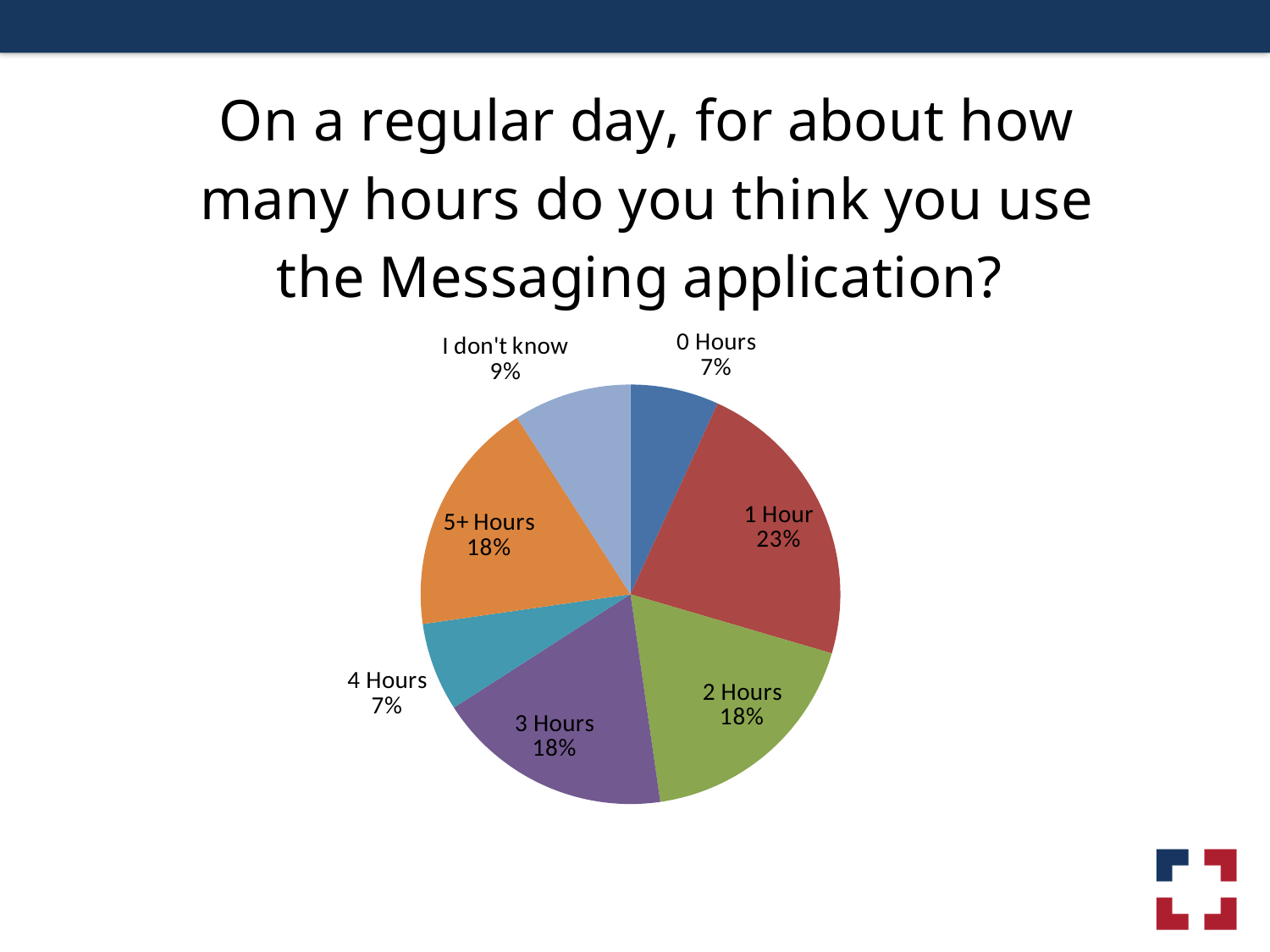
What percentage is shown for "5+ Hours"? 18% What colour is the "1 Hour" slice? Red How many categories share the value 18%? 3 What percentage is shown for "I don't know"? 9% What is the difference in percentage points between "1 Hour" and "0 Hours"? 16 Which category has the largest slice of the pie? 1 Hour What percentage is shown for "4 Hours"? 7% What share of the pie does the "1 Hour" slice represent? 23% Which is larger, the share for "3 Hours" or the share for "4 Hours"? 3 Hours What is the difference in percentage points between "2 Hours" and "I don't know"? 9 How many categories (slices) does the pie chart have? 7 What kind of chart is shown on the slide? Pie chart